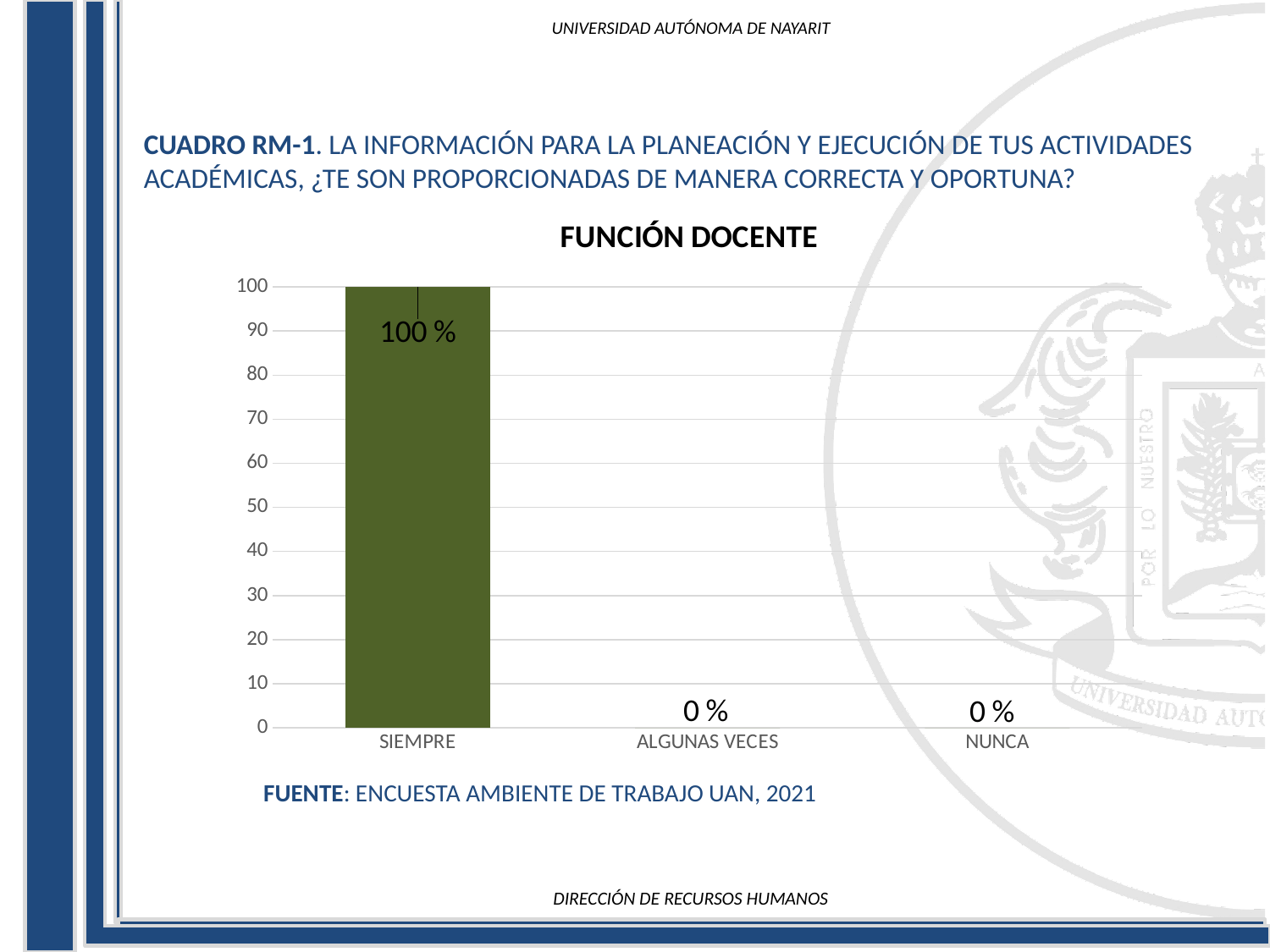
What is the value for NUNCA? 0 % What is the difference between the values for SIEMPRE and NUNCA? 100 % How many categories are shown on the x axis? 3 Do the values rise or fall from SIEMPRE to ALGUNAS VECES? fall What is the value for ALGUNAS VECES? 0 % What is the title of the chart? FUNCIÓN DOCENTE Which category has the highest value? SIEMPRE What is the highest value shown on the y axis? 100 What is the value for SIEMPRE? 100 % What kind of chart is shown? bar chart Is the value for SIEMPRE greater or less than 50? greater Which is larger, the value for SIEMPRE or the value for ALGUNAS VECES? SIEMPRE